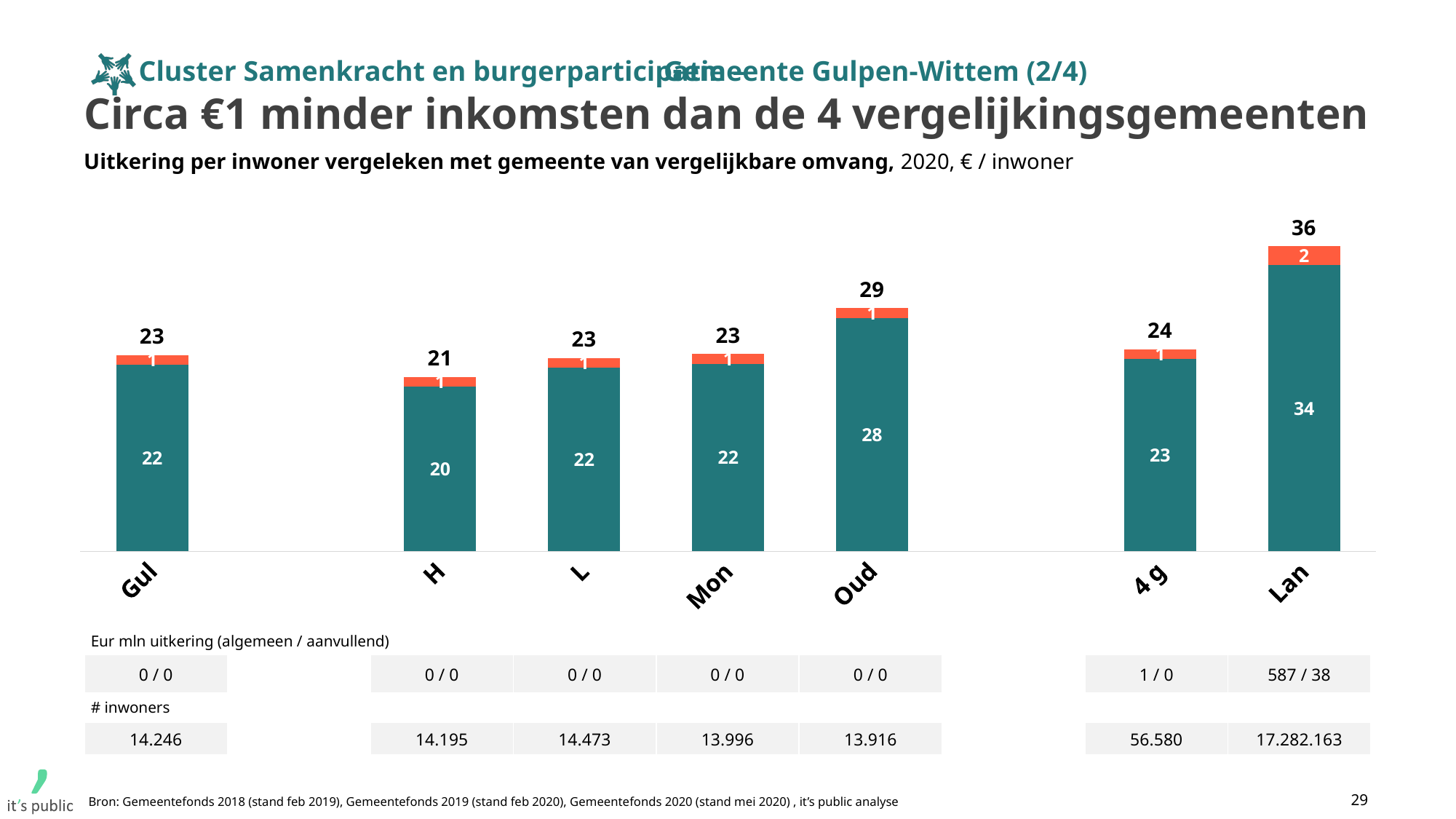
What is the value of the orange (upper) segment of the bar for Lan? 2 Which category has the lowest total value? H Which category has the highest total value? Lan What is the difference between the total for Oud and the total for 4 g? 5 What is the total of the stacked bar for H (sum of its two segments)? 21 What kind of chart is shown on the slide? Stacked bar chart Which has a larger total value, Oud or 4 g? Oud What is the total value shown above the bar for Gul? 23 How many categories are shown on the x axis of the chart? 7 What is the difference between the total for Lan and the total for Gul? 13 What is the value of the teal (lower) segment of the bar for Oud? 28 What is the total value shown above the bar for Lan? 36